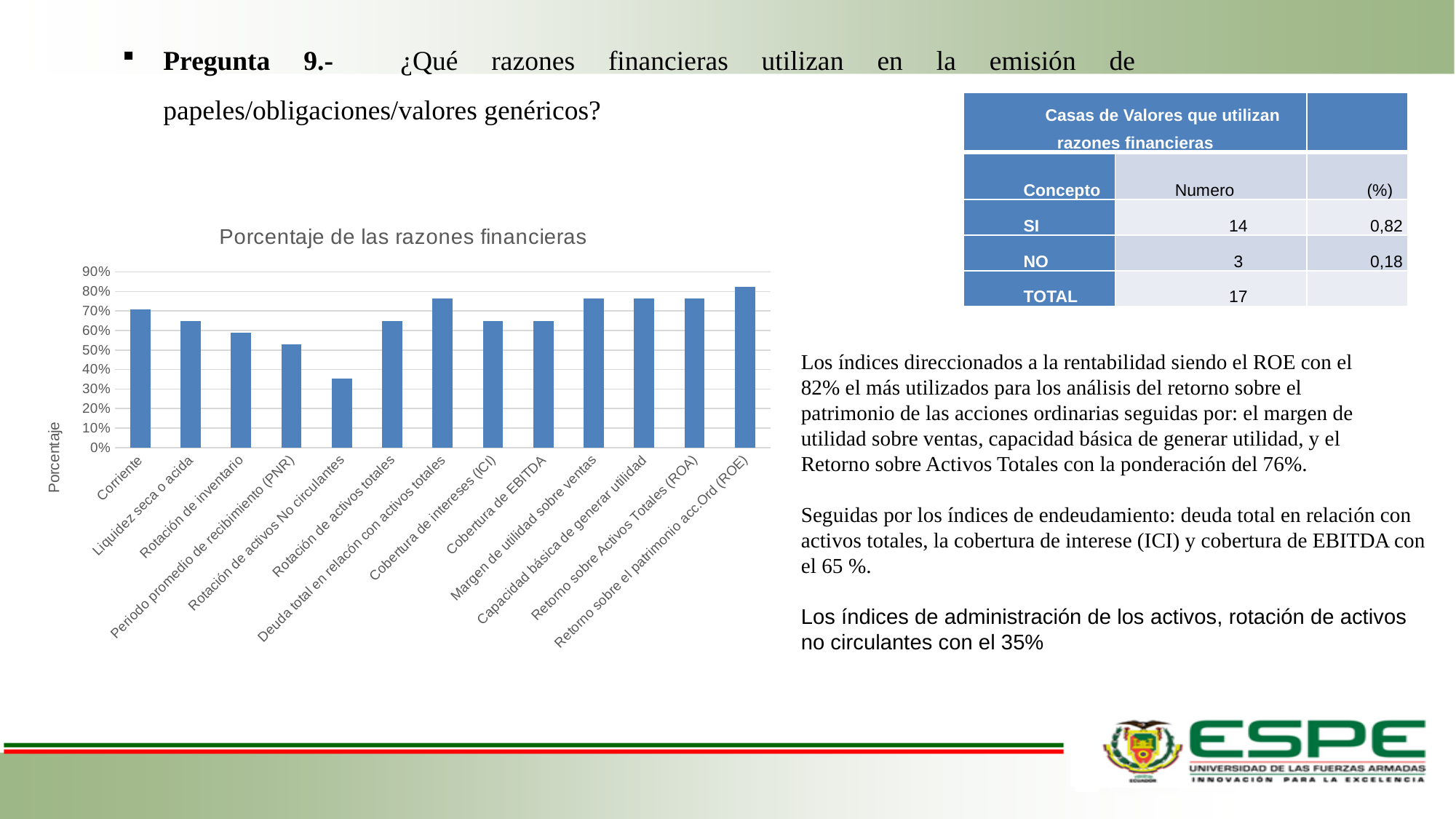
Is the value for Retorno sobre el patrimonio acc.Ord (ROE) greater or less than 80%? greater Which is larger, the value for Corriente or the value for Rotación de inventario? Corriente Which is larger, the value for Liquidez seca o ácida or the value for Periodo promedio de recibimiento (PNR)? Liquidez seca o ácida Is the value for Rotación de activos No circulantes greater or less than 40%? less Is the value for Corriente greater or less than 60%? greater How many categories (bars) are plotted in the chart? 13 What is the title of the chart? Porcentaje de las razones financieras What kind of chart is shown on the slide? Bar chart Which category has the lowest value in the chart? Rotación de activos No circulantes Which category has the highest value in the chart? Retorno sobre el patrimonio acc.Ord (ROE) What is the label of the vertical axis of the chart? Porcentaje